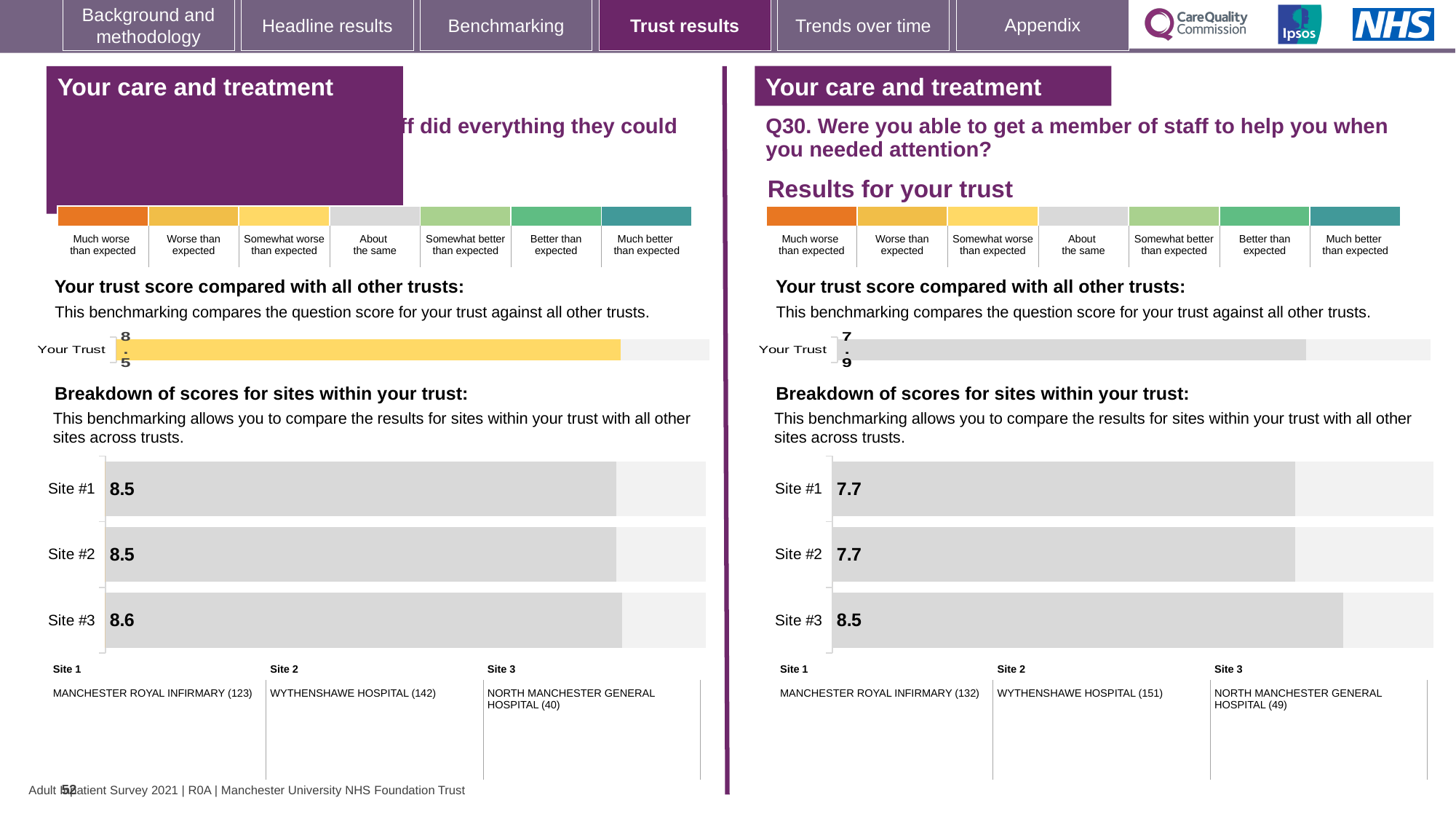
On the right-hand Q30 chart, what is the score for Site #3? 8.5 On the left-hand 'Your trust score compared with all other trusts' chart, what is the score for Your Trust? 8.5 On the left-hand chart, what is the score for Site #3? 8.6 On the right-hand Q30 site breakdown chart, what is the difference between the scores for Site #3 and Site #1? 0.8 On the left-hand chart, what is the score for Site #2? 8.5 On the left-hand site breakdown chart, what is the difference between the scores for Site #3 and Site #1? 0.1 On the right-hand Q30 chart, what is the score for Site #1? 7.7 On the right-hand Q30 site breakdown chart, which site has the highest score? Site #3 How many sites are shown in the right-hand Q30 site breakdown chart? 3 On the right-hand Q30 site breakdown chart, which is larger: the score for Site #2 or Site #3? Site #3 On the right-hand Q30 'Your trust score compared with all other trusts' chart, what is the score for Your Trust? 7.9 What type of chart is used for the site breakdown on the left-hand side of the slide? Bar chart